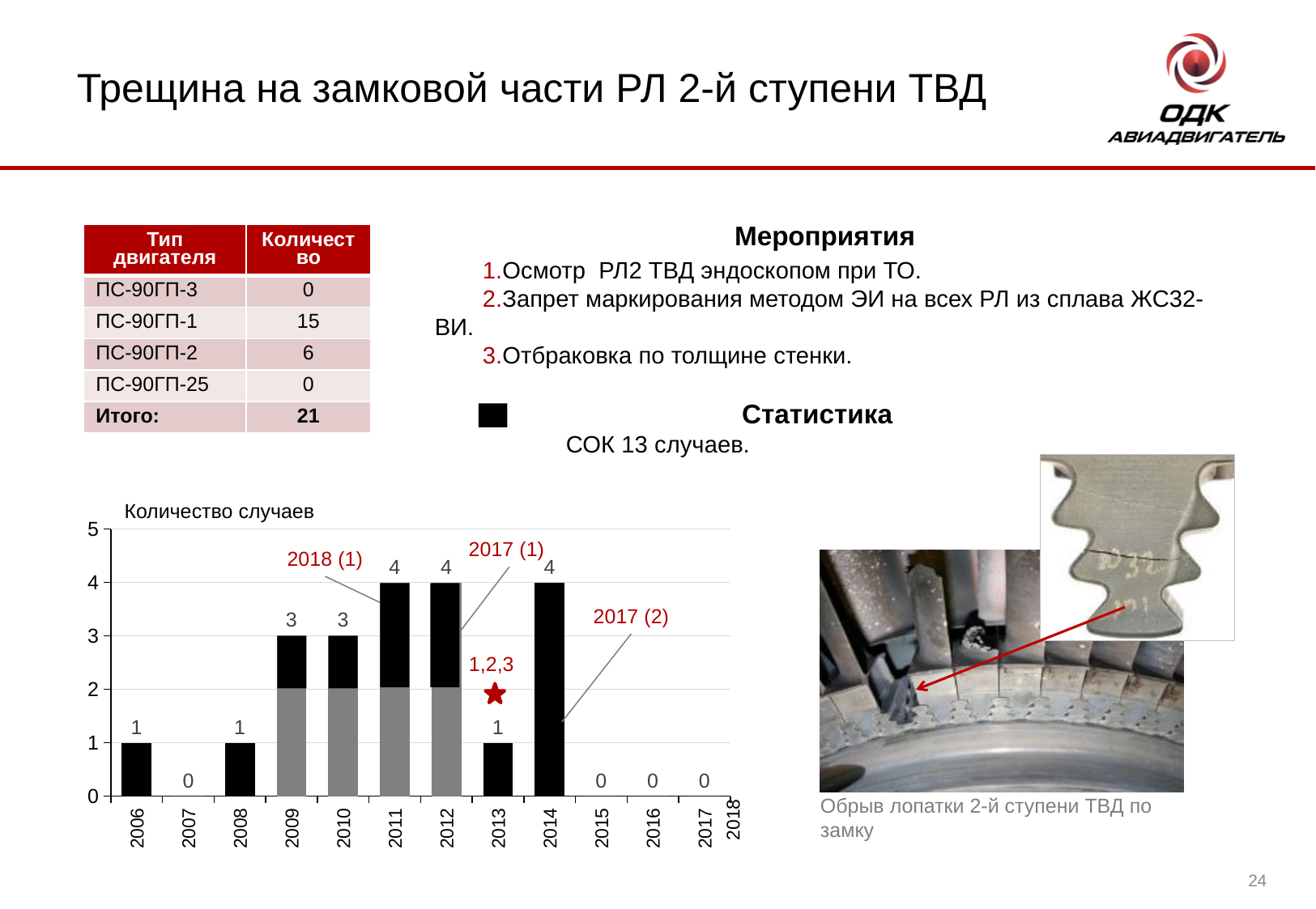
In the 'Количество случаев' chart, do the values rise or fall from 2014 to 2017? fall What is the value for 2009 in the 'Количество случаев' chart? 3 What is the value for 2013 in the 'Количество случаев' chart? 1 In the 'Количество случаев' chart, which year has the larger value, 2010 or 2013? 2010 What is the value for 2014 in the 'Количество случаев' chart? 4 What is the value for 2007 in the 'Количество случаев' chart? 0 In the 'Количество случаев' chart, is the value for 2012 greater or less than 3? greater In the 'Количество случаев' chart, what is the difference between the values for 2011 and 2009? 1 What kind of chart is the 'Количество случаев' chart? bar chart What is the title of the chart on the slide? Количество случаев What is the highest value shown in the 'Количество случаев' chart? 4 What is the lowest value shown in the 'Количество случаев' chart? 0